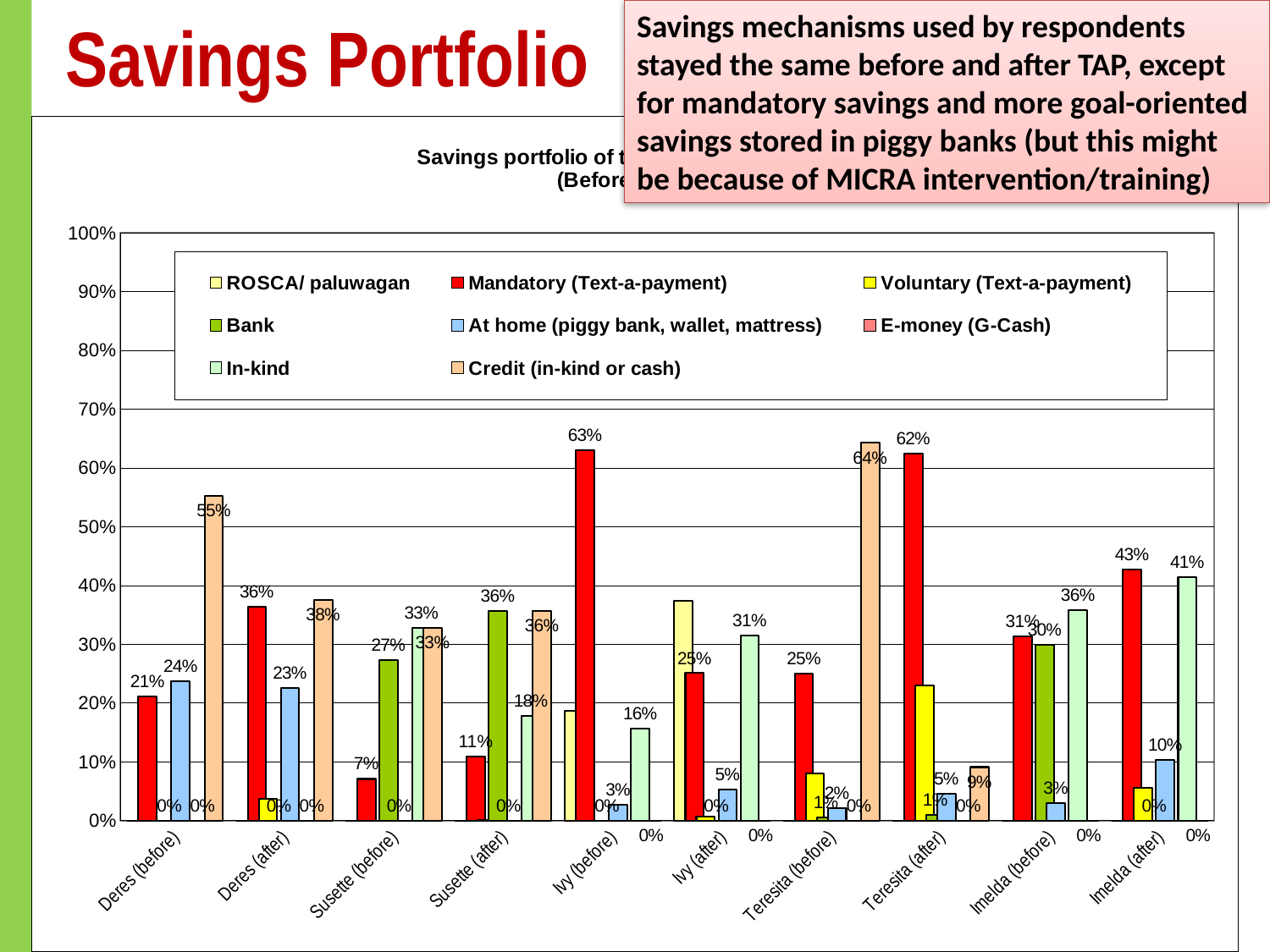
Which series is shown in red in the legend? Mandatory (Text-a-payment) What is the Mandatory (Text-a-payment) value for Ivy (before)? 63% Which category has the highest Mandatory (Text-a-payment) value? Ivy (before) How many series does the legend list? 8 How many categories are shown on the x axis? 10 What is the Credit (in-kind or cash) value for Deres (before)? 55% Which is larger: the Credit (in-kind or cash) value for Teresita (before) or for Teresita (after)? Teresita (before) What is the At home (piggy bank, wallet, mattress) value for Deres (after)? 23% What type of chart is shown on the slide? bar chart Which category has the lowest Mandatory (Text-a-payment) value? Susette (before) What is the difference between the Mandatory (Text-a-payment) values for Imelda (after) and Imelda (before)? 12% What is the In-kind value for Imelda (after)? 41%